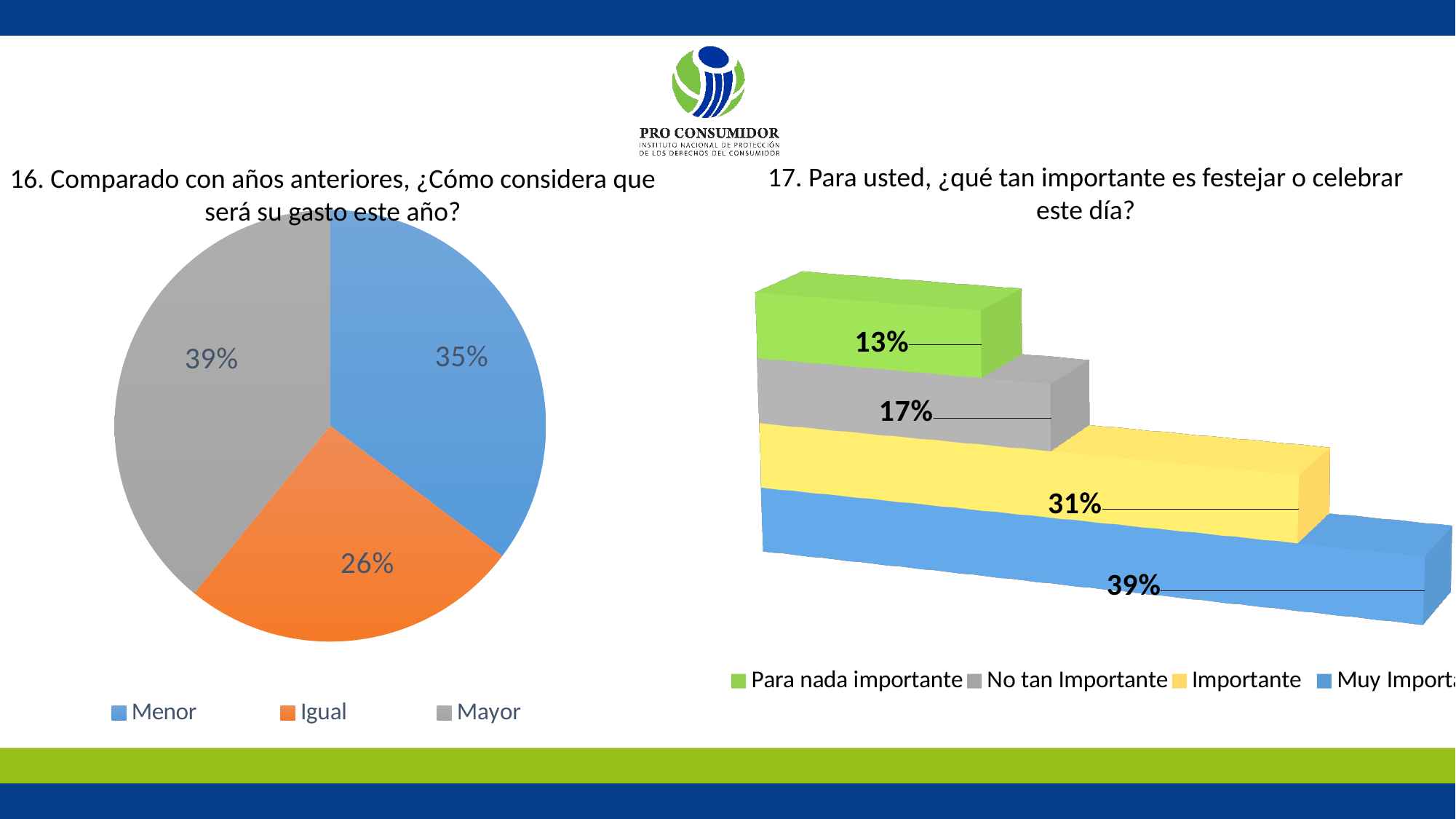
In the pie chart for question 16, how many slices are there? 3 In the bar chart for question 17, how many categories does the legend list? 4 In the bar chart for question 17, what is the difference in percentage points between Importante and No tan Importante? 14 What type of chart is used for question 16 on the left of the slide? Pie chart In the pie chart for question 16, which category has the largest share? Mayor In the pie chart for question 16, which category has the smallest share? Igual In the pie chart for question 16, what is the difference in percentage points between Mayor and Menor? 4 In the pie chart for question 16, what percentage is shown for Mayor? 39% In the bar chart for question 17, what percentage is shown for Importante? 31% In the bar chart for question 17, which category has the lowest value? Para nada importante In the bar chart for question 17, what percentage is shown for Para nada importante? 13% In the pie chart for question 16, what percentage is shown for Igual? 26%